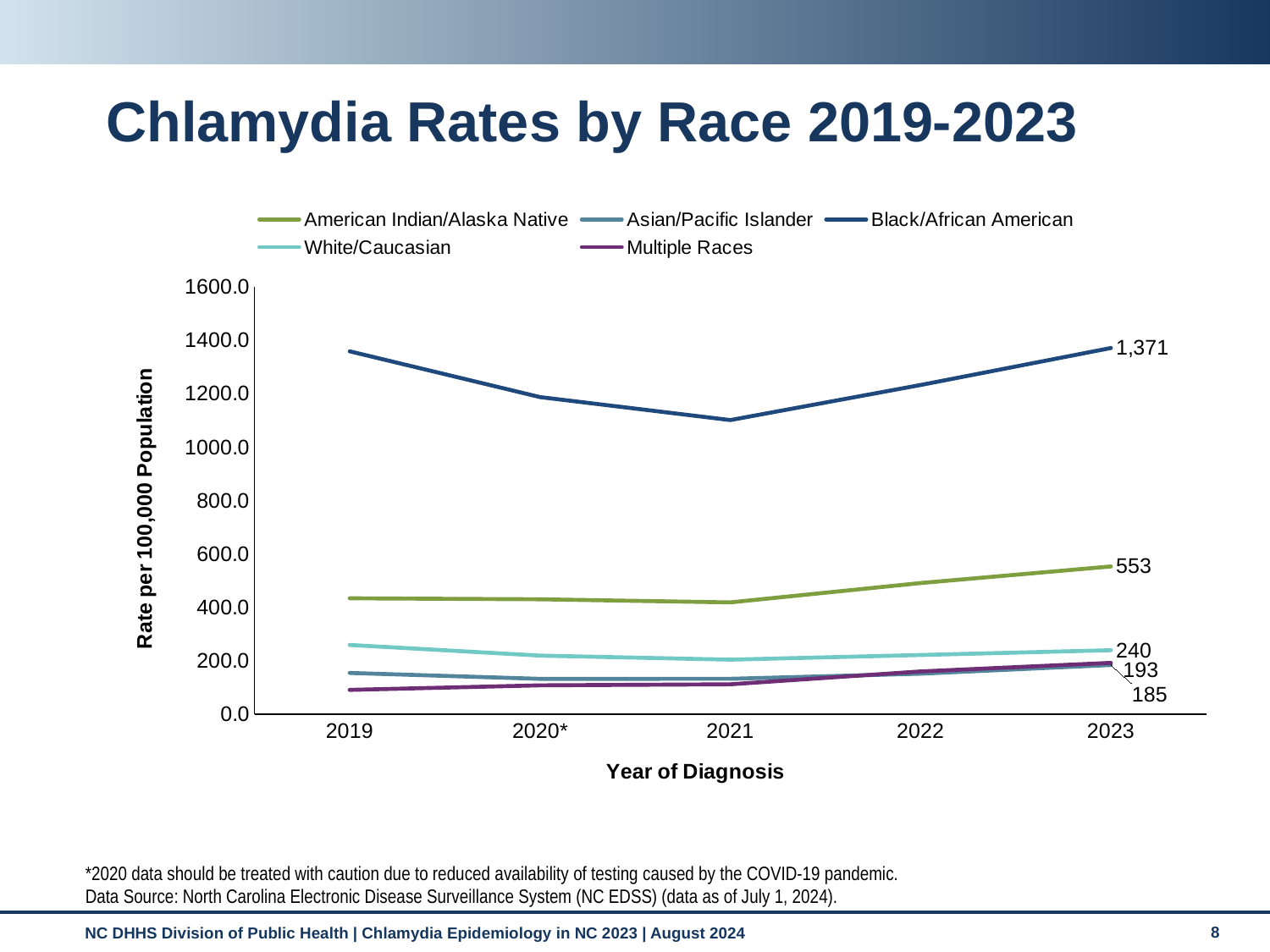
Is the value for Black/African American in 2019 greater or less than 1200? greater Is the value for American Indian/Alaska Native in 2019 greater or less than 600? less Which race group has the highest chlamydia rate in 2023? Black/African American Does the Black/African American rate rise or fall from 2021 to 2023? rise What is the difference between the 2023 rates for American Indian/Alaska Native and White/Caucasian? 313 What is the chlamydia rate for Black/African American in 2023? 1,371 How many series does the legend list? 5 What type of chart is shown on the slide? line chart What is the difference between the 2023 rates for Black/African American and American Indian/Alaska Native? 818 What is the chlamydia rate for American Indian/Alaska Native in 2023? 553 What is the chlamydia rate for White/Caucasian in 2023? 240 How many years are plotted along the x axis? 5